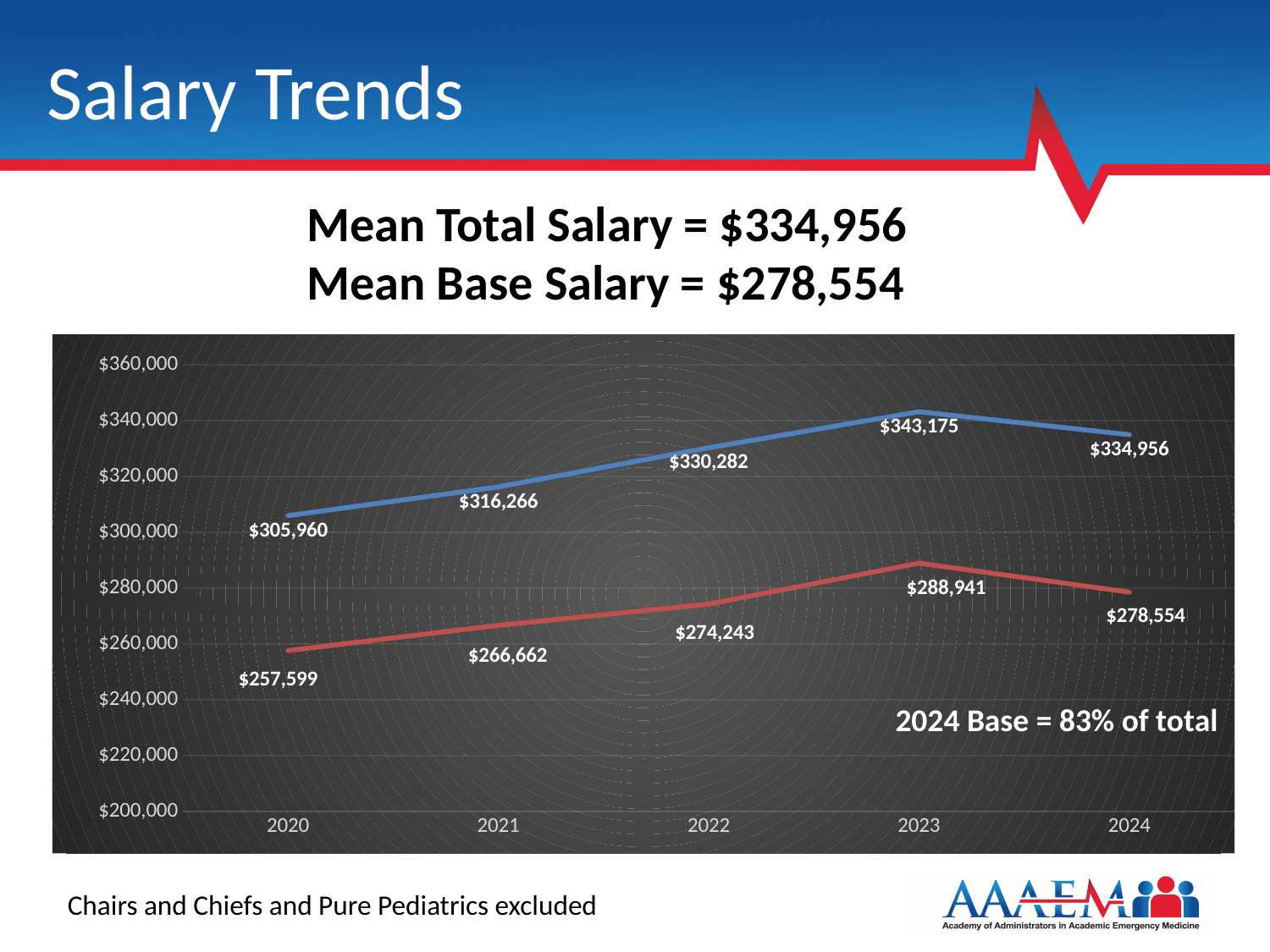
What type of chart is shown on the slide? line chart What is the mean total salary value plotted for 2020? $305,960 Does the mean total salary line rise or fall from 2020 to 2023? rise Which is larger: the mean base salary in 2023 or the mean base salary in 2022? 2023 In which year is the mean base salary line at its lowest? 2020 What is the difference between the mean total salary and the mean base salary in 2024? $56,402 How many years are plotted on the x axis? 5 What is the mean total salary value plotted for 2023? $343,175 What is the mean base salary value plotted for 2024? $278,554 In which year is the mean total salary line at its highest? 2023 According to the text on the chart, what percentage of total salary does the 2024 base salary represent? 83% What is the mean base salary value plotted for 2021? $266,662